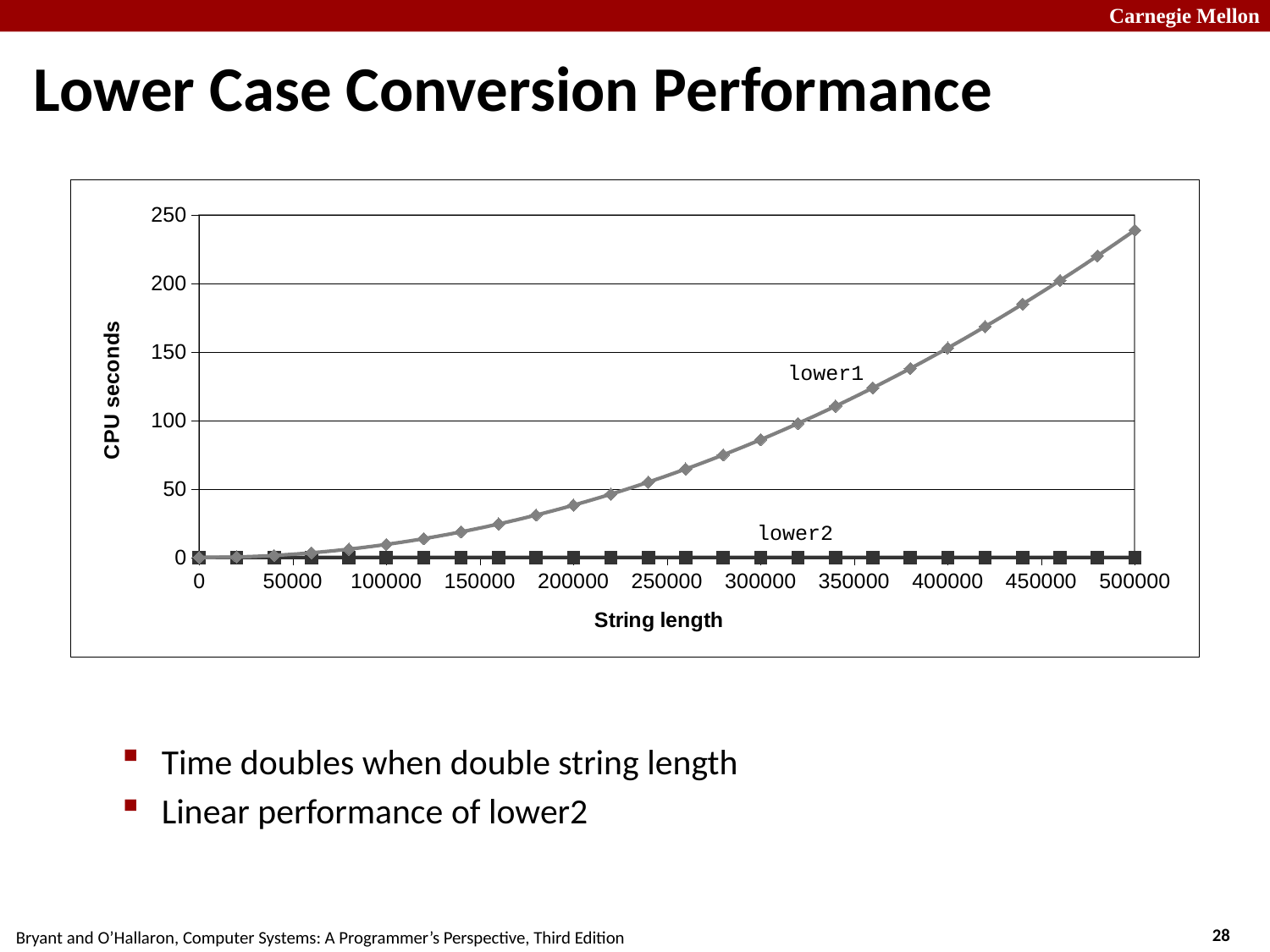
Is the value for lower2 at a string length of 500000 greater or less than 50? less Which series has the higher CPU seconds at a string length of 500000, lower1 or lower2? lower1 What kind of chart is shown on the slide? line chart Which series stays lowest across all string lengths? lower2 What is the title of the slide's chart? Lower Case Conversion Performance Is the value for lower1 at a string length of 300000 greater or less than 100? less How many series are plotted in the chart? 2 Is the value for lower1 at a string length of 400000 greater or less than 100? greater What is the label of the y axis? CPU seconds Does the lower1 series rise or fall as string length increases? rise